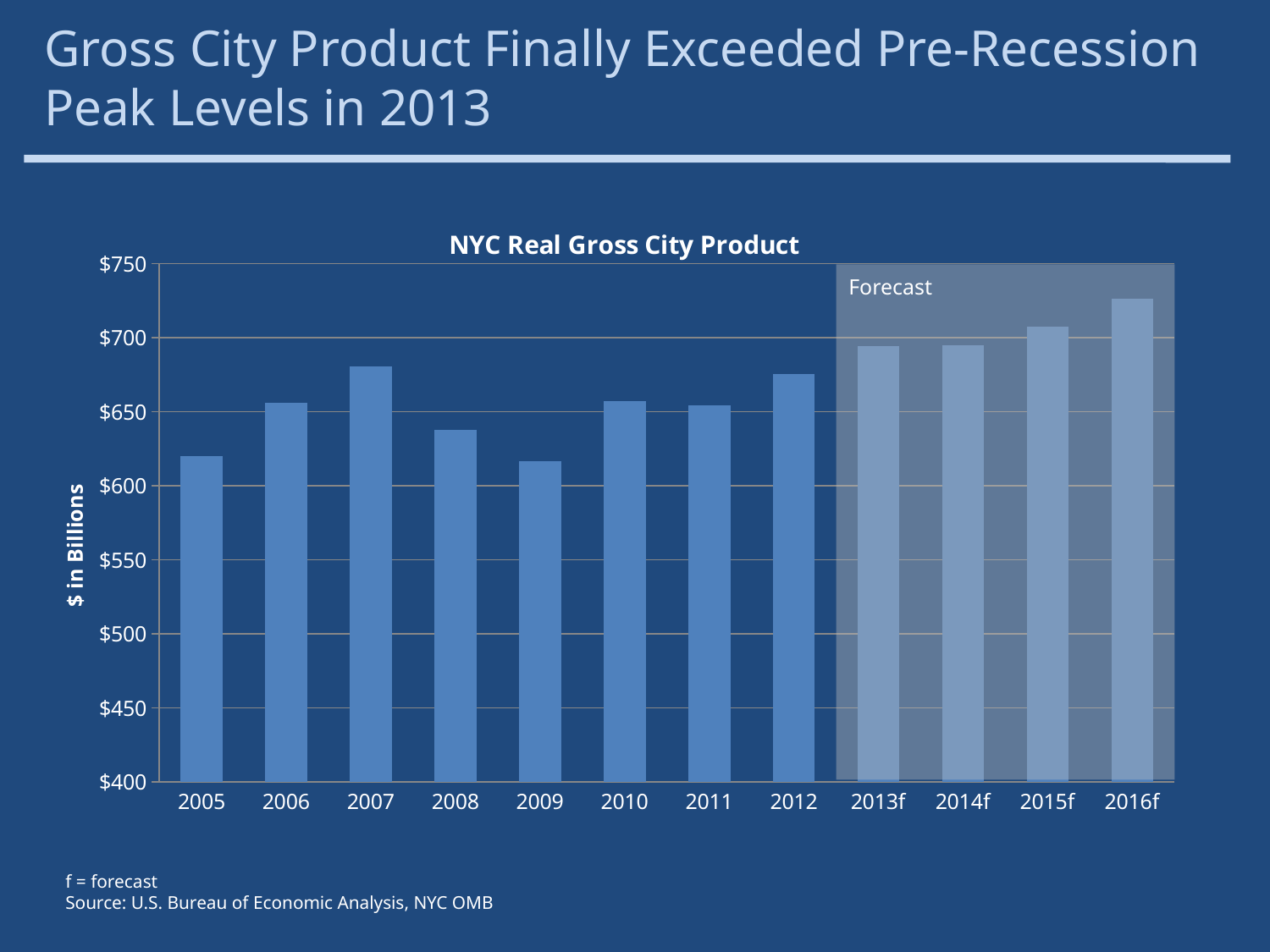
What is the label on the vertical axis of the chart? $ in Billions Do the values rise or fall from 2007 to 2009? fall Is the value for 2007 greater or less than $650? greater Which is larger, the value for 2007 or the value for 2008? 2007 Is the value for 2016f greater or less than $700? greater Is the value for 2012 greater or less than $700? less What type of chart is shown on the slide? bar chart How many years are shown on the x axis of the chart? 12 Which year has the highest value in the chart? 2016f What is the title of the chart? NYC Real Gross City Product